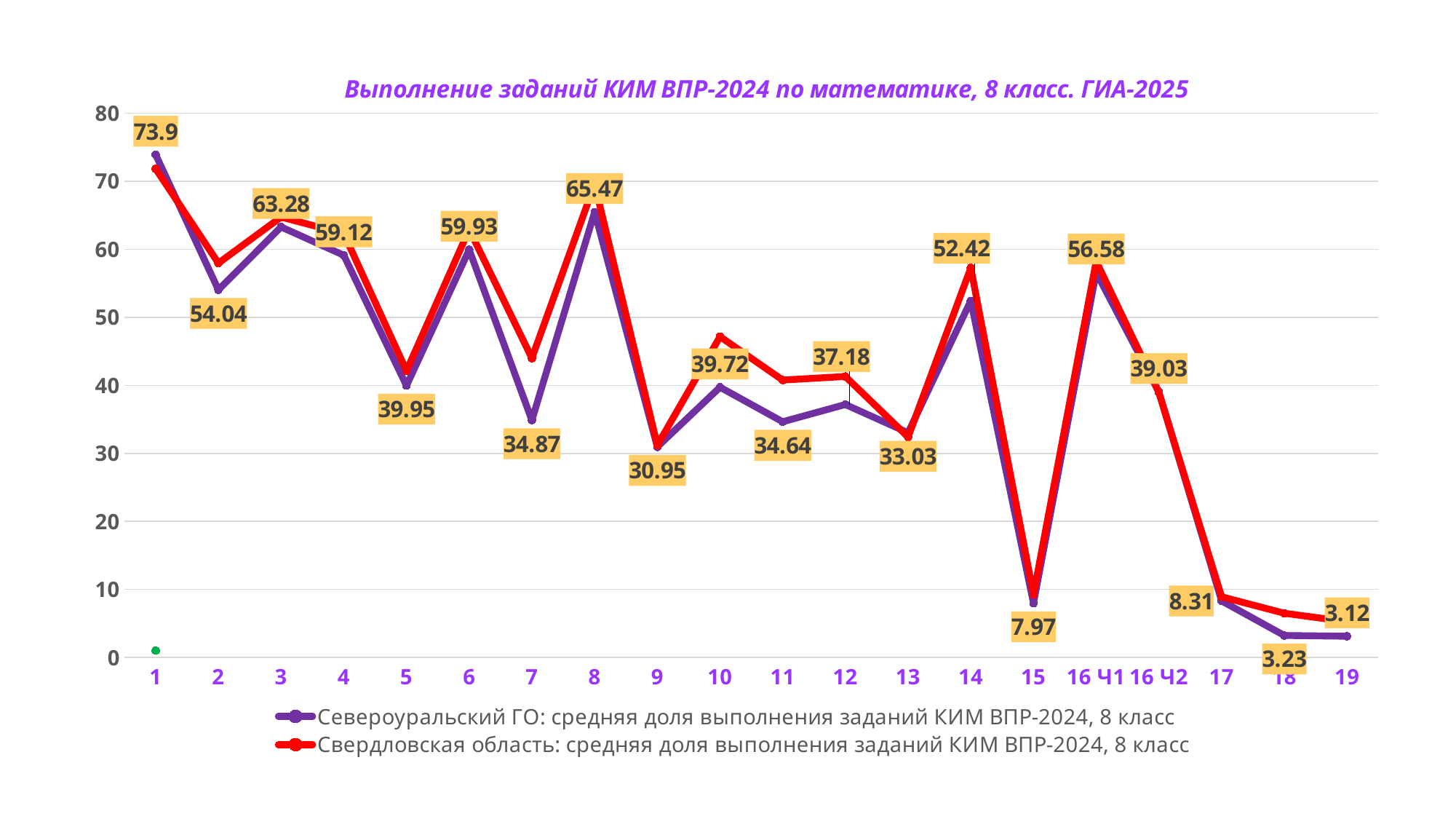
What is the value for Североуральский ГО at task 8? 65.47 Is the value for Свердловская область at task 15 greater or less than 20? less How many series does the legend list? 2 What is the difference between the Североуральский ГО values at task 1 and task 2? 19.86 Which is larger for Североуральский ГО: the value at task 6 or at task 7? task 6 Which task has the lowest value for Североуральский ГО? 19 How many categories are shown on the x axis? 20 What is the value for Североуральский ГО at task 16 Ч1? 56.58 What type of chart is shown on the slide? line chart Which task has the highest value for Североуральский ГО? 1 Is the value for Свердловская область at task 2 greater or less than 50? greater What is the value for Североуральский ГО at task 15? 7.97